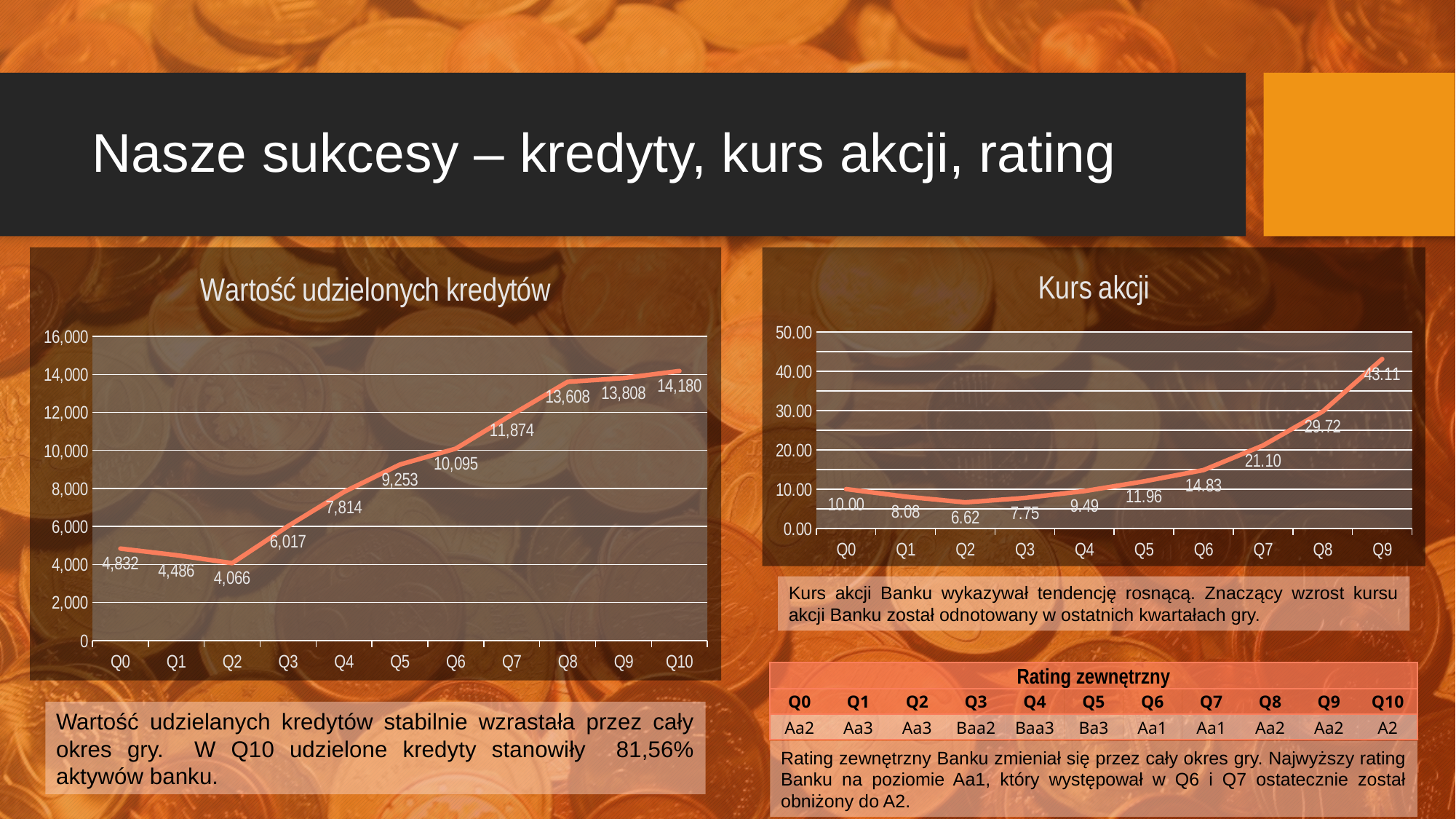
In the 'Kurs akcji' chart, what is the difference between the values for Q9 and Q8? 13.39 What kind of chart is 'Wartość udzielonych kredytów'? Line chart In the 'Kurs akcji' chart, which quarter has the highest value? Q9 In the 'Kurs akcji' chart, what is the value for Q7? 21.10 In the 'Wartość udzielonych kredytów' chart, what is the difference between the values for Q10 and Q0? 9,348 In the 'Kurs akcji' chart, which quarter has the lowest value? Q2 In the 'Wartość udzielonych kredytów' chart, is the value for Q7 greater or less than 10,000? greater In the 'Kurs akcji' chart, do the values rise or fall from Q2 to Q9? Rise In the 'Wartość udzielonych kredytów' chart, what is the value for Q5? 9,253 In the 'Wartość udzielonych kredytów' chart, how many quarters are plotted on the x axis? 11 In the 'Wartość udzielonych kredytów' chart, which quarter has the lowest value? Q2 In the 'Kurs akcji' chart, which is larger, the value for Q1 or the value for Q4? Q4